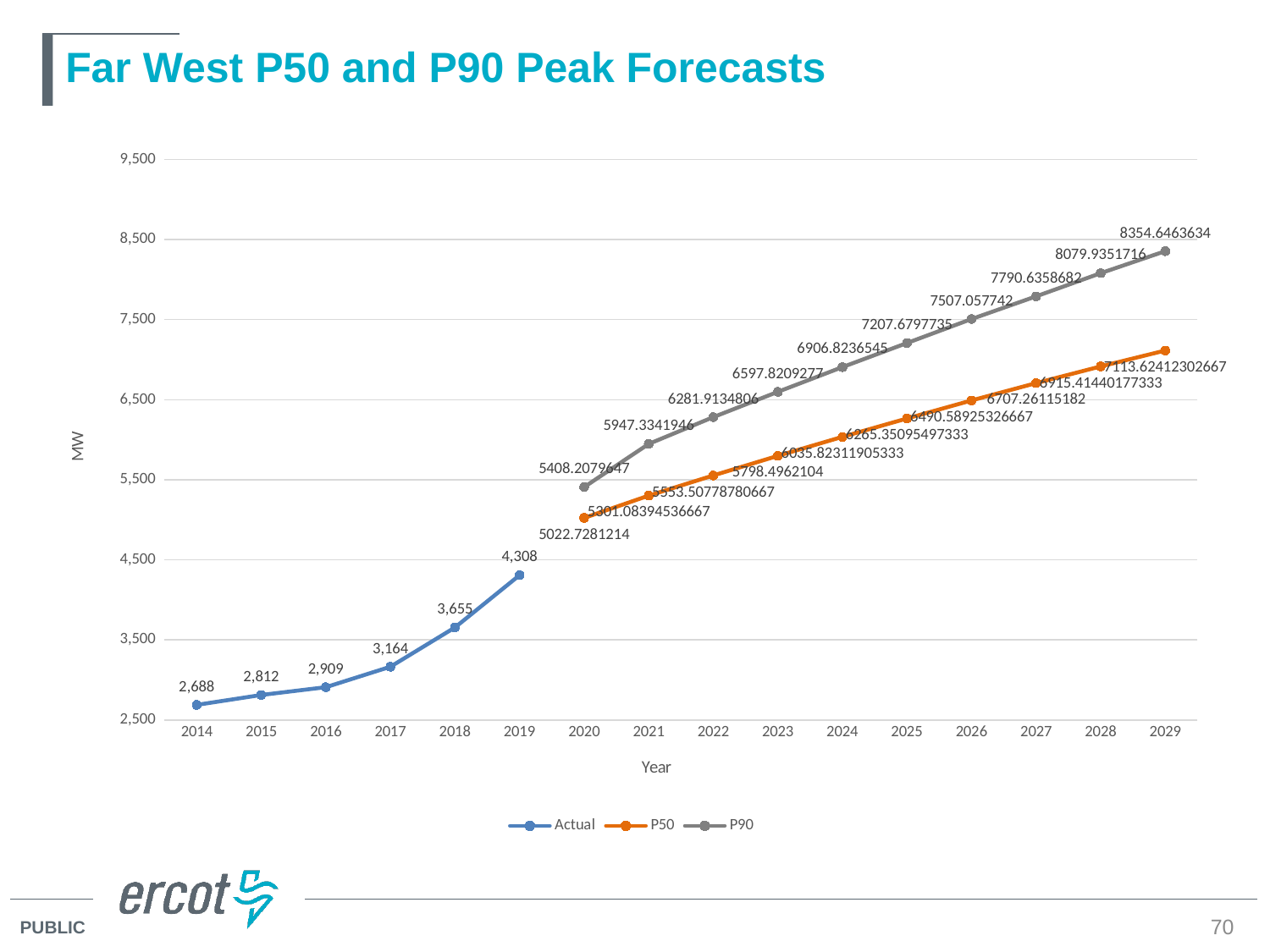
What is the Actual value for 2019? 4,308 Which year has the highest Actual value? 2019 What is the P50 value for 2020? 5022.7281214 What is the difference between the Actual values for 2019 and 2018? 653 What is the P90 value for 2029? 8354.6463634 Which year has the lowest Actual value? 2014 What kind of chart is shown on the slide? line chart Is the P50 value for 2029 greater or less than 7,500? less What is the label on the y axis? MW How many series does the legend list? 3 In 2025, which series has the larger value, P50 or P90? P90 What is the Actual value for 2014? 2,688